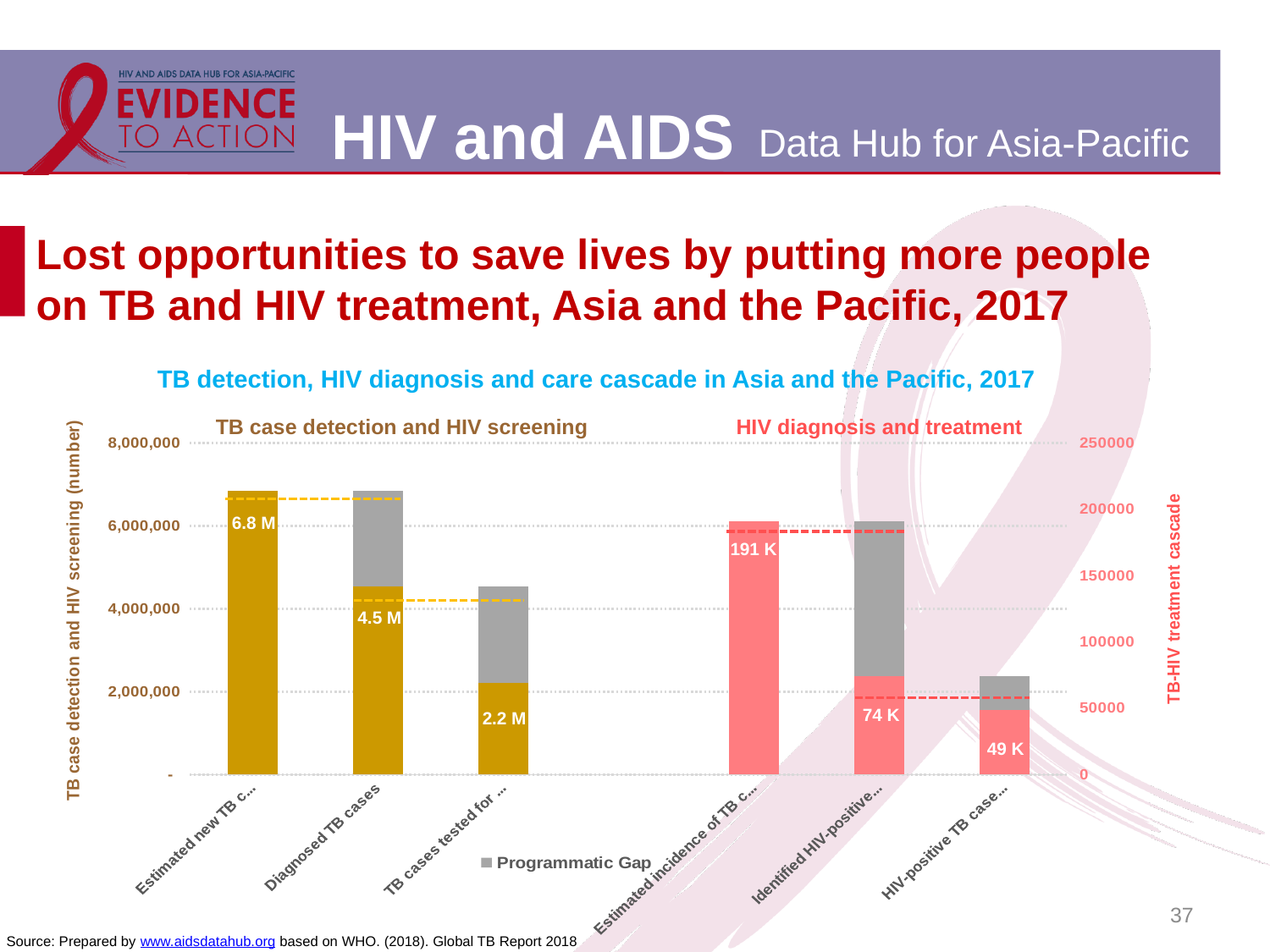
What is the value shown for the Estimated new TB cases bar? 6.8 M What is the value shown for the HIV-positive TB cases bar? 49 K What is the value shown for the Identified HIV-positive bar? 74 K What is the value shown for Diagnosed TB cases? 4.5 M What is the value shown for the Estimated incidence of TB bar in the HIV diagnosis and treatment group? 191 K Which bar in the HIV diagnosis and treatment group has the lowest labelled value? HIV-positive TB cases (49 K) How many bars are plotted in the chart in total? 6 What is the value shown for the TB cases tested bar? 2.2 M What type of chart is shown on the slide? bar chart What is the difference between the Estimated new TB cases value (6.8 M) and the Diagnosed TB cases value (4.5 M)? 2.3 M Do the labelled values in the TB case detection and HIV screening group rise or fall from left to right? fall What is the difference between the Identified HIV-positive value (74 K) and the HIV-positive TB cases value (49 K)? 25 K